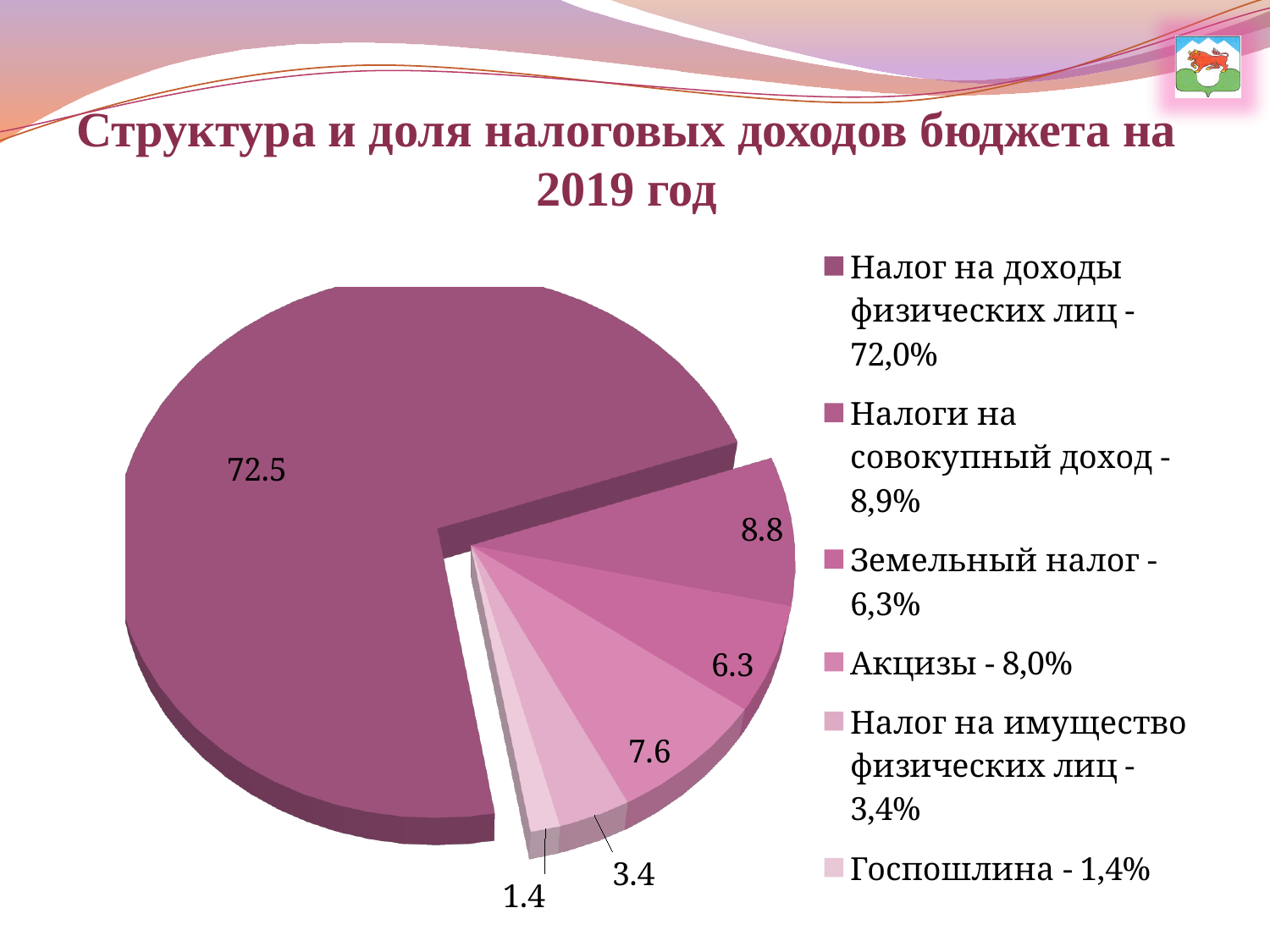
What data label is shown on the slice for Налоги на совокупный доход? 8.8 Which category has the smallest slice in the pie chart? Госпошлина What type of chart is shown on the slide? pie chart How many slices does the pie chart have? 6 What is the title of the chart on the slide? Структура и доля налоговых доходов бюджета на 2019 год What is the difference between the data labels for Налоги на совокупный доход (8.8) and Земельный налог (6.3)? 2.5 According to the legend, what share does Акцизы have? 8,0% According to the legend, what share does Госпошлина have? 1,4% Which slice is larger: Акцизы (7.6) or Налог на имущество физических лиц (3.4)? Акцизы What data label is shown on the slice for Земельный налог? 6.3 How many entries does the legend list? 6 What data label is shown on the largest slice of the pie chart? 72.5